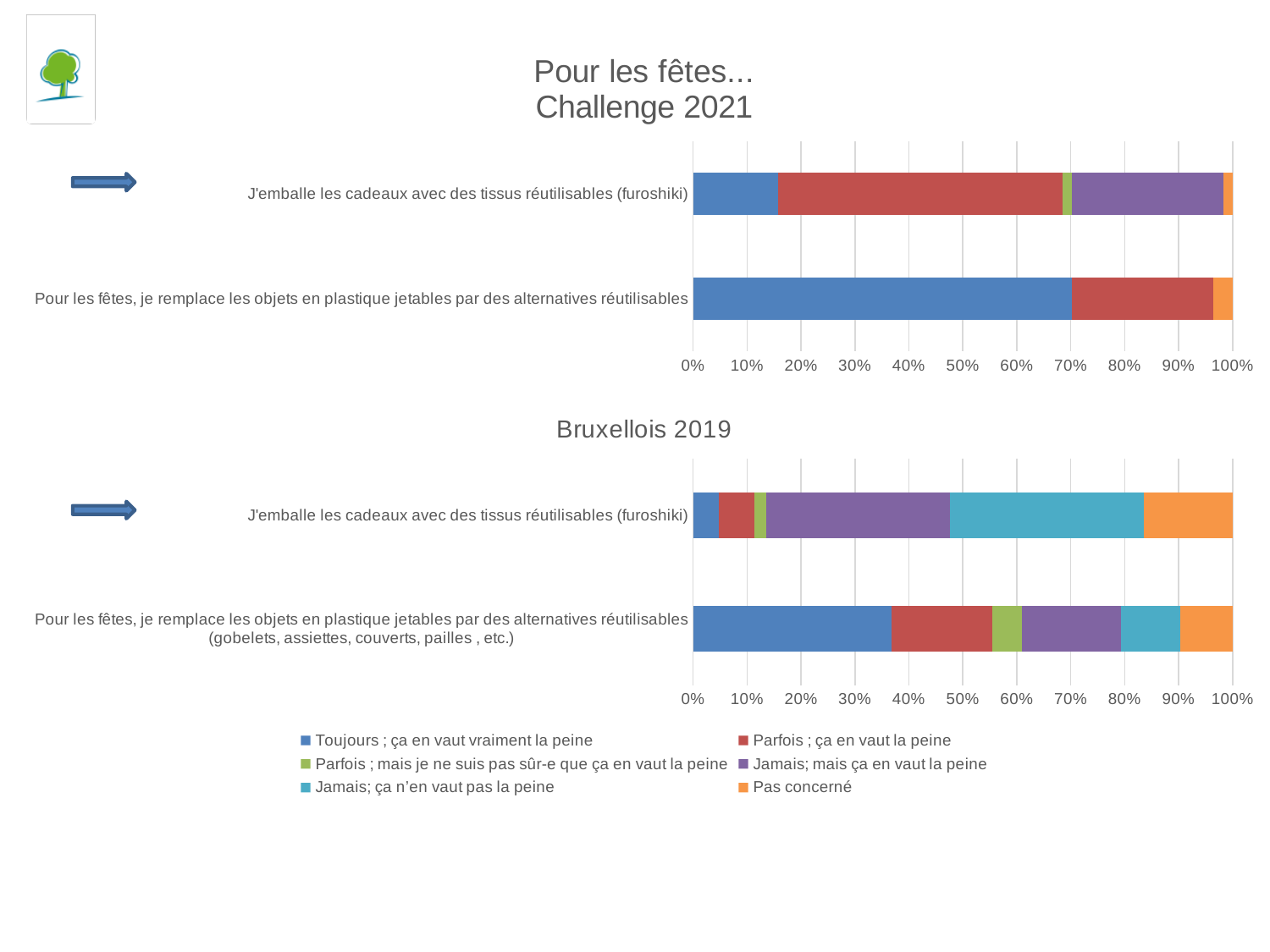
In the Bruxellois 2019 chart, is the 'Toujours ; ça en vaut vraiment la peine' value for 'J'emballe les cadeaux avec des tissus réutilisables (furoshiki)' greater or less than 10%? less In the Challenge 2021 chart, is the 'Toujours ; ça en vaut vraiment la peine' value for 'Pour les fêtes, je remplace les objets en plastique jetables par des alternatives réutilisables' greater or less than 60%? greater In the Bruxellois 2019 chart, is the 'Toujours ; ça en vaut vraiment la peine' value for 'Pour les fêtes, je remplace les objets en plastique jetables par des alternatives réutilisables' greater or less than 30%? greater What is the title of the top chart? Pour les fêtes... Challenge 2021 In the Bruxellois 2019 chart, which category has the larger 'Jamais; ça n'en vaut pas la peine' share? J'emballe les cadeaux avec des tissus réutilisables (furoshiki) In the Challenge 2021 chart, which category has the larger 'Toujours ; ça en vaut vraiment la peine' share: the furoshiki item or the plastique jetables item? Pour les fêtes, je remplace les objets en plastique jetables par des alternatives réutilisables What kind of chart is the Challenge 2021 chart? bar chart In the Bruxellois 2019 chart, which category has the larger 'Pas concerné' share: the furoshiki item or the plastique jetables item? J'emballe les cadeaux avec des tissus réutilisables (furoshiki) How many categories are shown in the Bruxellois 2019 chart? 2 How many series does the legend list? 6 Which legend entry is shown in orange? Pas concerné